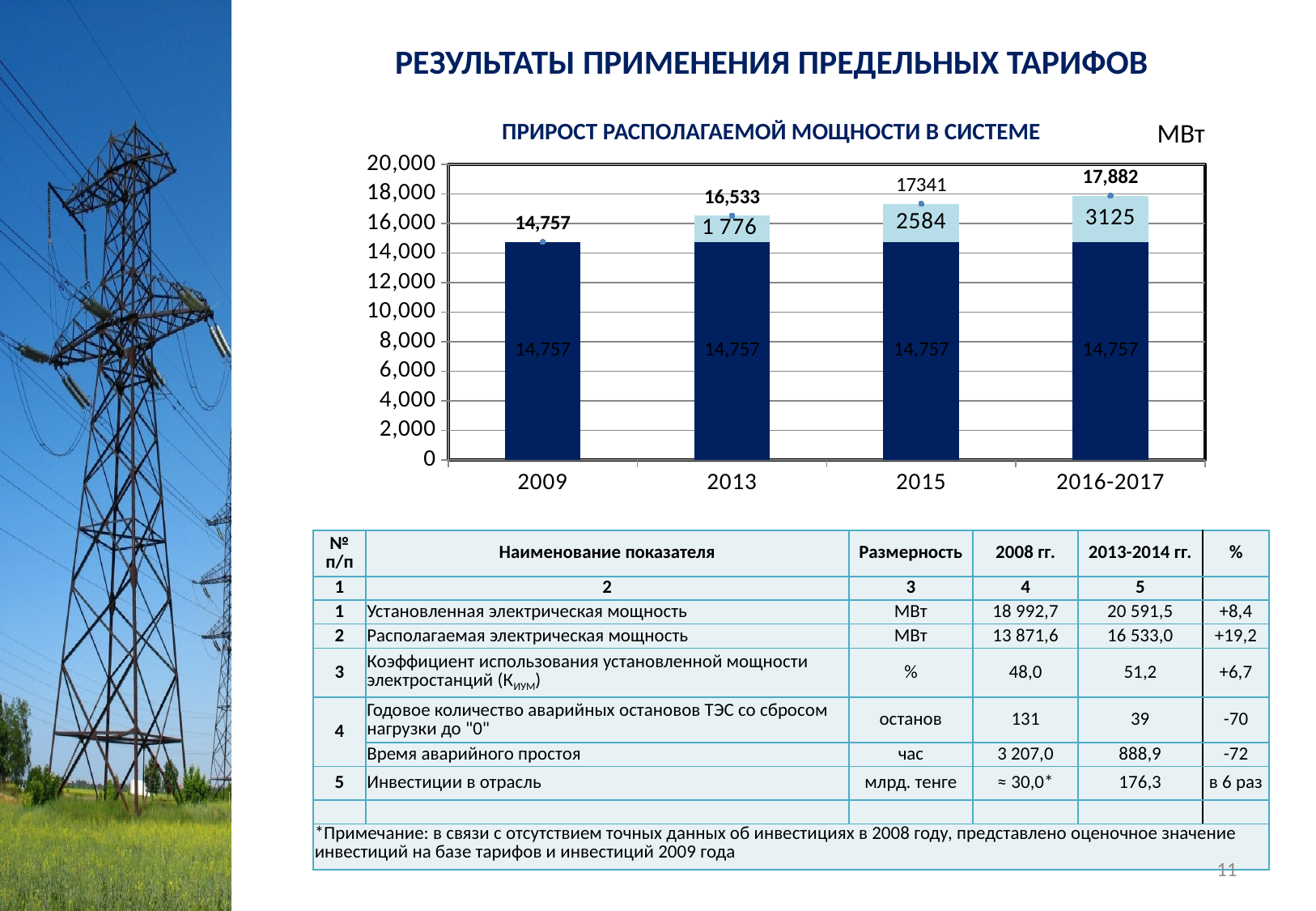
What unit is indicated next to the chart title? МВт What type of chart is shown under the title 'ПРИРОСТ РАСПОЛАГАЕМОЙ МОЩНОСТИ В СИСТЕМЕ'? bar chart Which category has the lowest total value in the chart? 2009 What is the value of the light-blue increment segment for 2015? 2584 What is the total value labelled above the bar for 2013? 16,533 Which is larger: the increment segment for 2013 or the increment segment for 2015? 2015 Do the total values rise or fall from 2009 to 2016-2017 along the x axis? rise What is the difference between the total for 2016-2017 (17,882) and the total for 2009 (14,757)? 3,125 What is the value of the light-blue increment segment for 2016-2017? 3125 Which category has the highest total value in the chart? 2016-2017 How many categories are shown on the x axis of the chart? 4 What is the value of the dark-blue base segment for 2009? 14,757